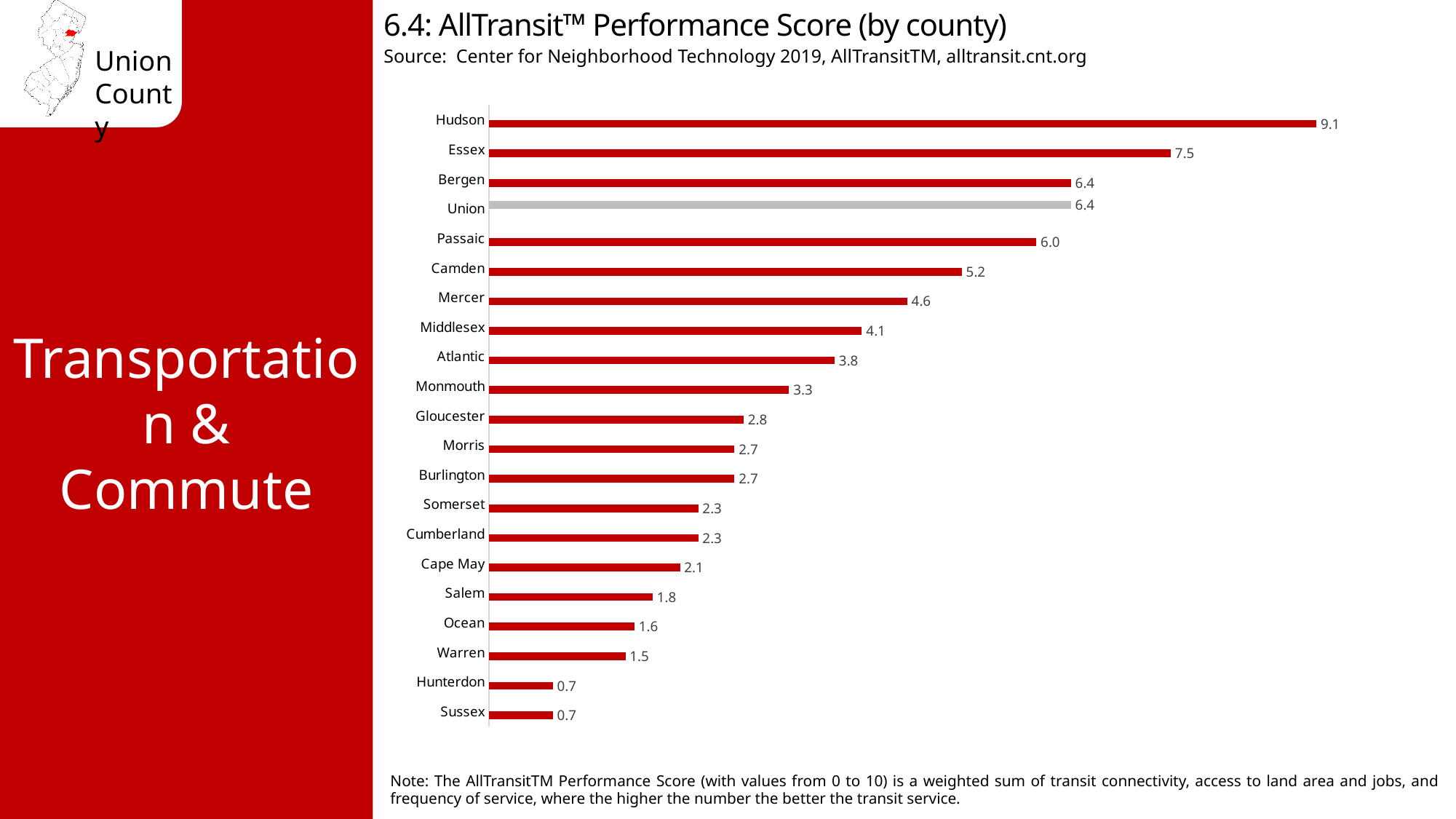
What type of chart is used to show the AllTransit Performance Scores? Bar chart What is the difference between the scores of Union and Passaic counties? 0.4 How many counties are shown in the chart? 21 Which county's bar is shown in grey rather than red? Union What is the AllTransit Performance Score for Union County? 6.4 Which county has the highest AllTransit Performance Score? Hudson What is the difference between the scores of Hudson and Essex counties? 1.6 What is the AllTransit Performance Score for Warren County? 1.5 What is the AllTransit Performance Score for Mercer County? 4.6 Which county has a higher score, Monmouth or Atlantic? Atlantic What is the AllTransit Performance Score for Hudson County? 9.1 Which county has a higher score, Camden or Middlesex? Camden